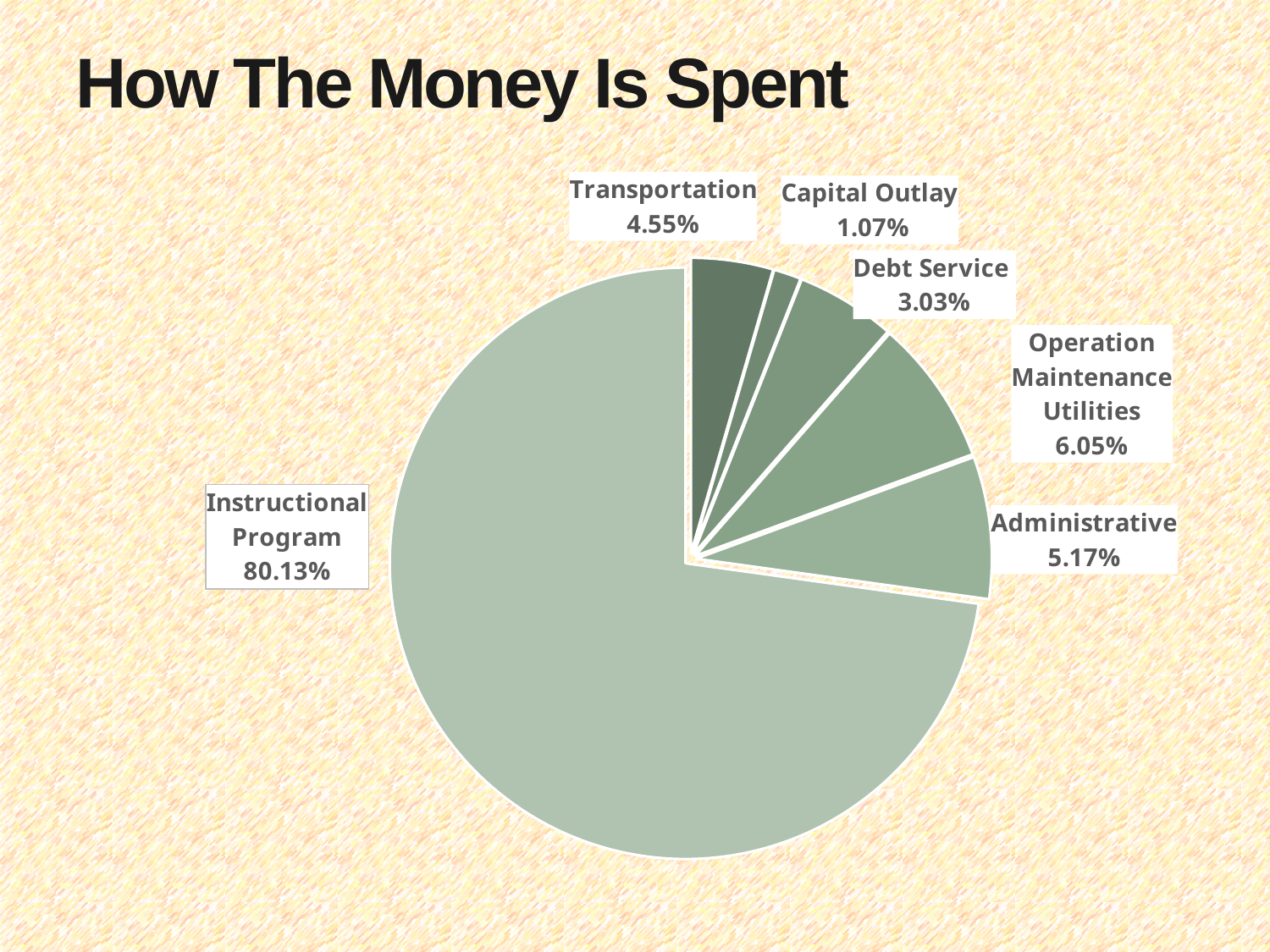
What percentage is shown for Capital Outlay? 1.07% What percentage is shown for Operation Maintenance Utilities? 6.05% What share of spending goes to the Instructional Program? 80.13% What percentage is shown for Administrative? 5.17% What percentage is shown for Transportation? 4.55% Which category has the smallest share of spending? Capital Outlay What percentage is shown for Debt Service? 3.03% What is the difference between the Operation Maintenance Utilities share and the Debt Service share? 3.02% How many categories are shown in the pie chart? 6 Which is larger, the share for Administrative or the share for Transportation? Administrative What kind of chart is shown on the slide? pie chart Which category has the largest share of spending? Instructional Program